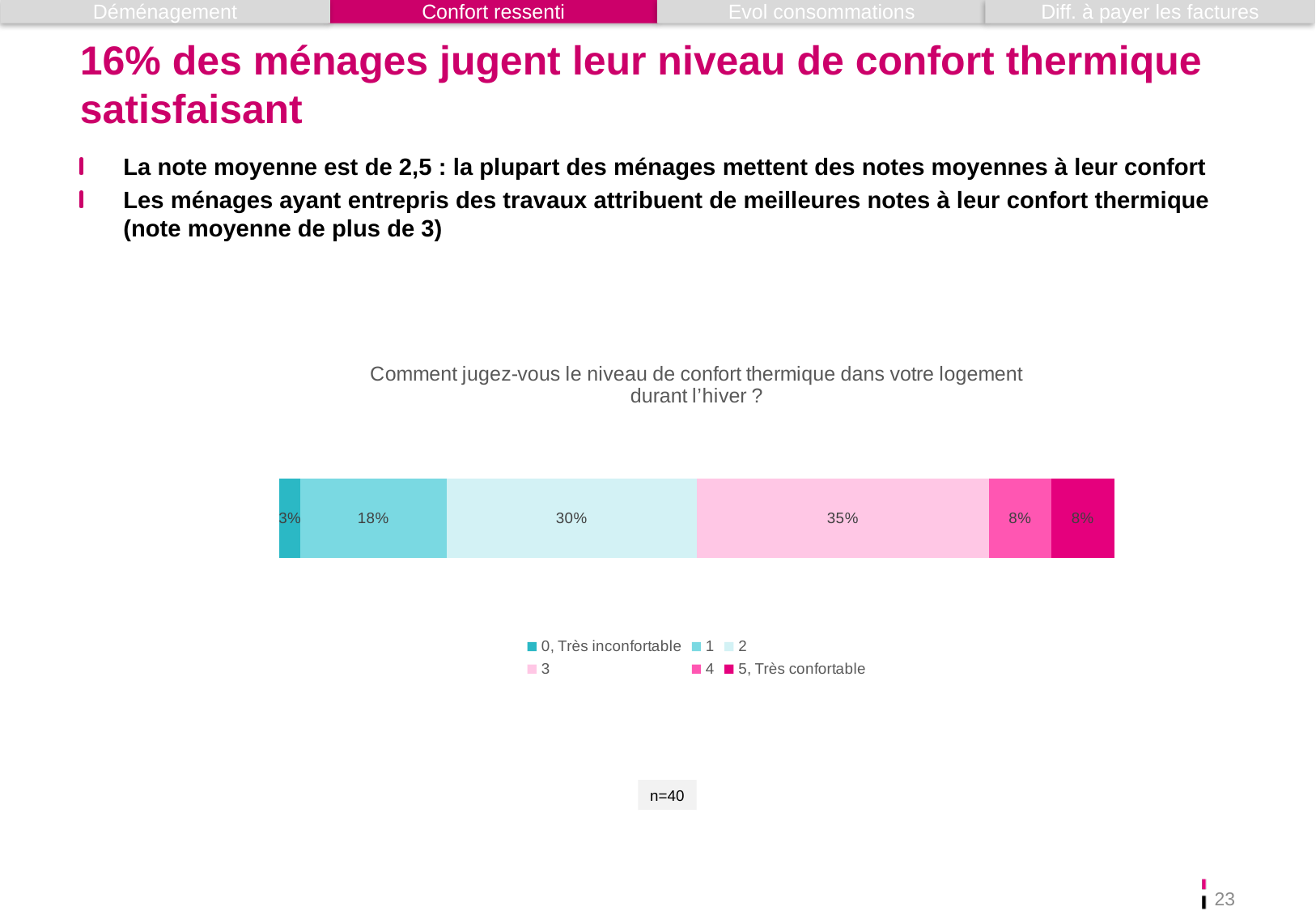
Which is larger: the share rating 1 or the share rating 4? 1 What percentage of households rated their thermal comfort as 2? 30% What percentage of households chose '5, Très confortable'? 8% Which rating has the largest share of households? 3 Which rating has the smallest share of households? 0, Très inconfortable How many series does the legend list? 6 What percentage of households rated their thermal comfort as 3? 35% What is the difference between the share rating 3 and the share rating 2? 5% What is the sample size shown below the chart? n=40 What percentage of households rated their thermal comfort as 1? 18% What percentage of households chose '0, Très inconfortable'? 3% What kind of chart is shown on the slide? Stacked bar chart